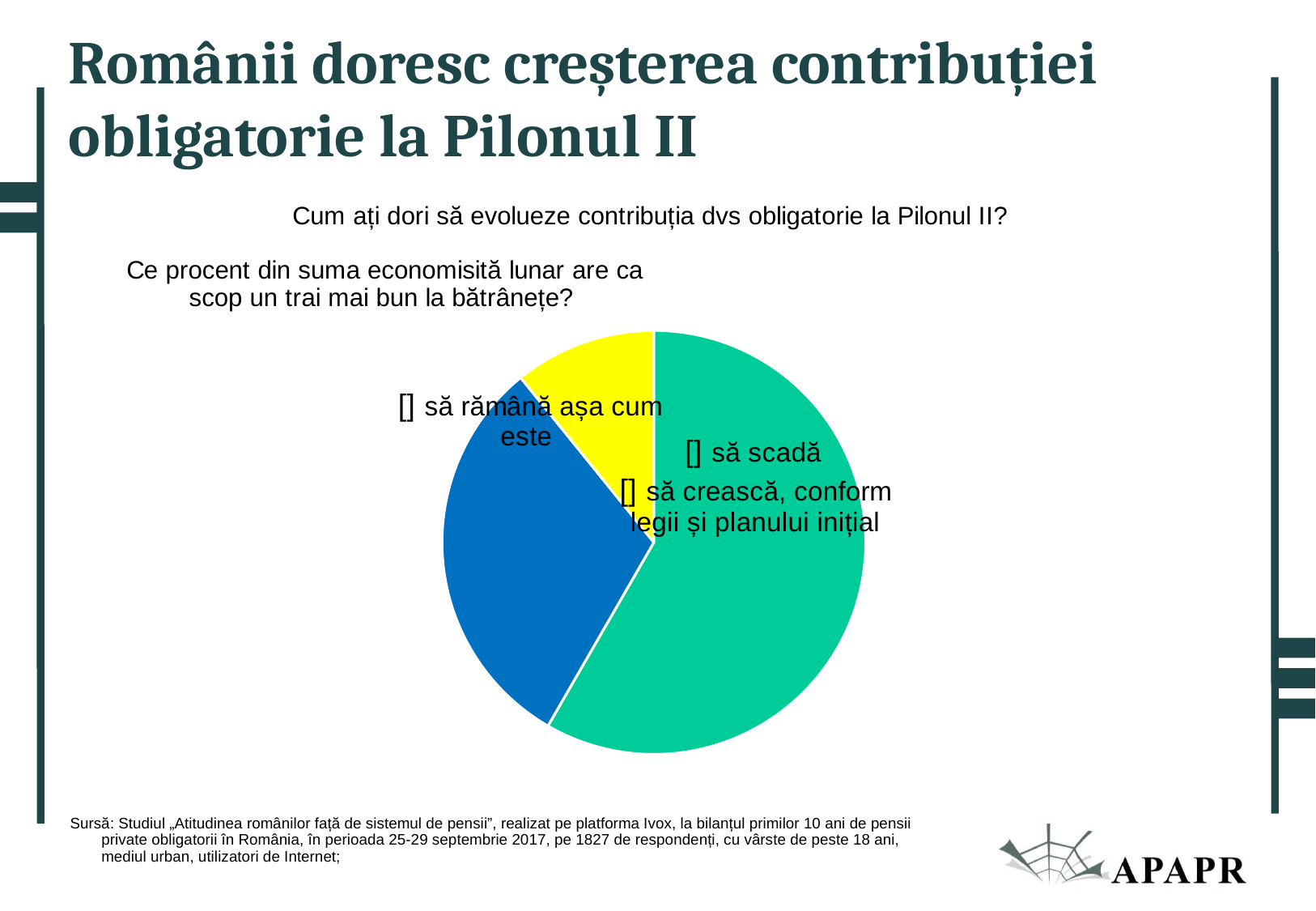
Does the 'să crească, conform legii și planului inițial' slice cover more or less than half of the pie? more What kind of chart is shown on the slide? pie chart Which slice is larger: 'să crească, conform legii și planului inițial' or 'să rămână așa cum este'? să crească, conform legii și planului inițial Which response has the smallest slice of the pie chart? să scadă How many slices does the pie chart have? 3 What colour is the 'să scadă' slice? yellow What colour is the 'să rămână așa cum este' slice? blue Which response has the largest slice of the pie chart? să crească, conform legii și planului inițial Does the 'să scadă' slice cover more or less than a quarter of the pie? less Which slice is larger: 'să rămână așa cum este' or 'să scadă'? să rămână așa cum este